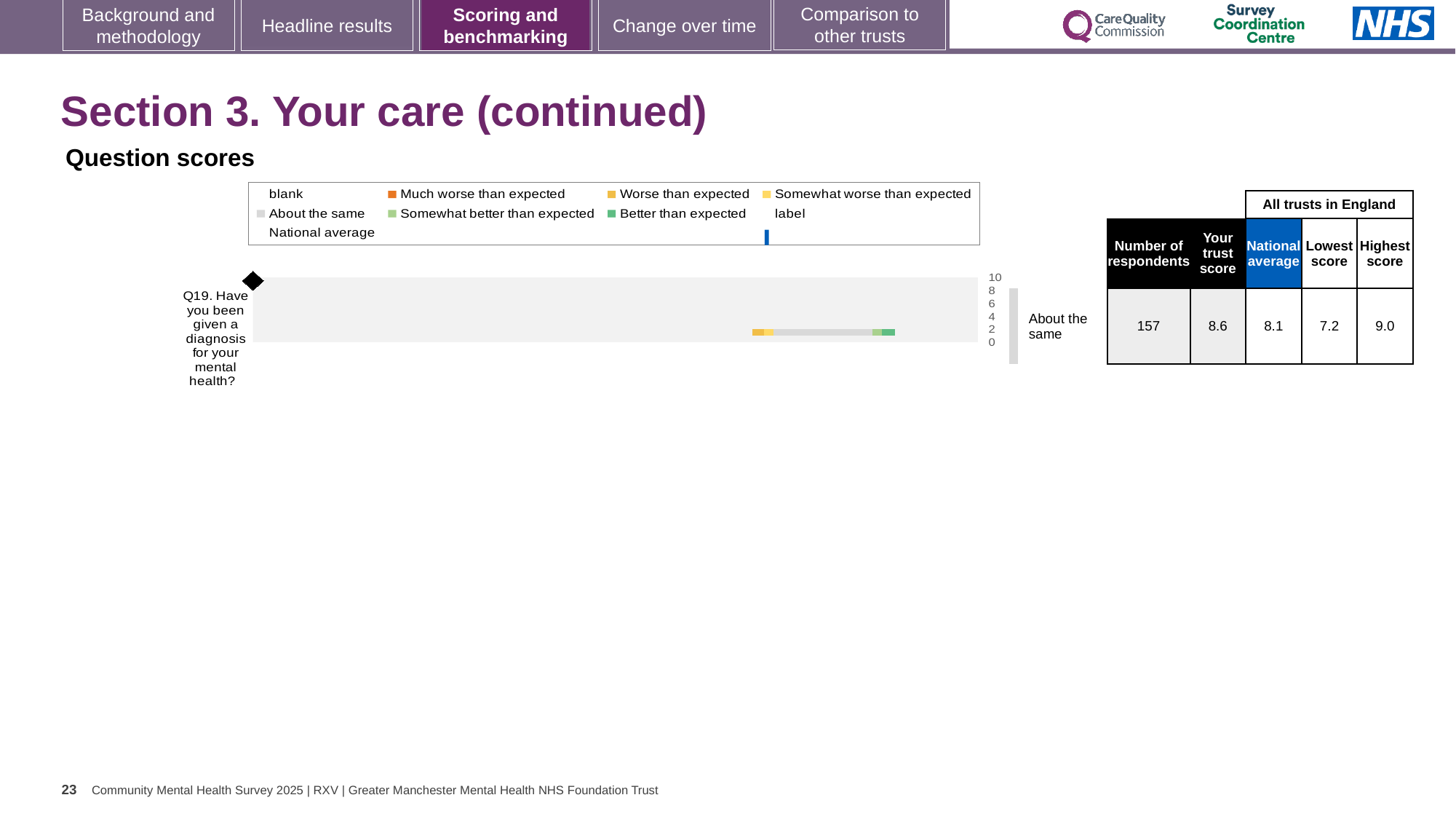
How many respondents answered Q19? 157 What is the lowest score among all trusts in England for Q19? 7.2 Which is larger for Q19, the trust score or the national average? Your trust score What is the national average score for Q19? 8.1 Is the trust score for Q19 greater or less than 8? greater What kind of chart is used to show the question score for Q19? Bar chart What benchmark category is shown for Q19? About the same What is the highest score among all trusts in England for Q19? 9.0 What is the difference between the trust score and the national average for Q19? 0.5 What is the trust score for Q19 (Have you been given a diagnosis for your mental health?)? 8.6 How many questions are plotted on the chart? 1 What is the difference between the highest and lowest scores for Q19 across all trusts in England? 1.8